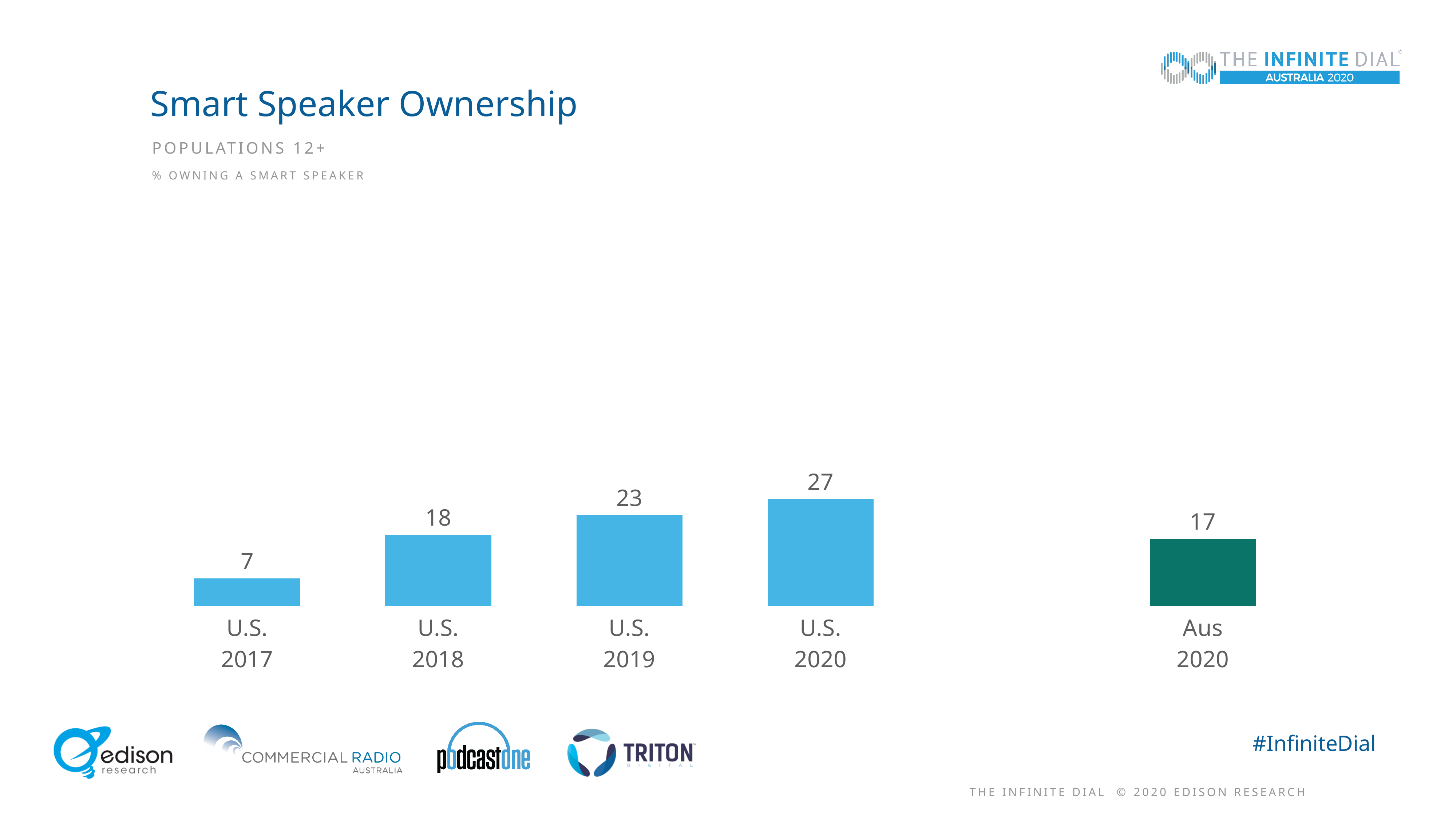
What is the difference between the values for U.S. 2020 and Aus 2020? 10 Do the U.S. values rise or fall from 2017 to 2020? Rise How many bars are shown in the chart? 5 Which category has the highest value? U.S. 2020 Which category has the lowest value? U.S. 2017 What is the value for U.S. 2017? 7 Which is larger, the value for U.S. 2018 or Aus 2020? U.S. 2018 What is the difference between the values for U.S. 2018 and U.S. 2017? 11 What kind of chart is shown on the slide? Bar chart What is the value for U.S. 2019? 23 What is the value for U.S. 2020? 27 What is the value for Aus 2020? 17